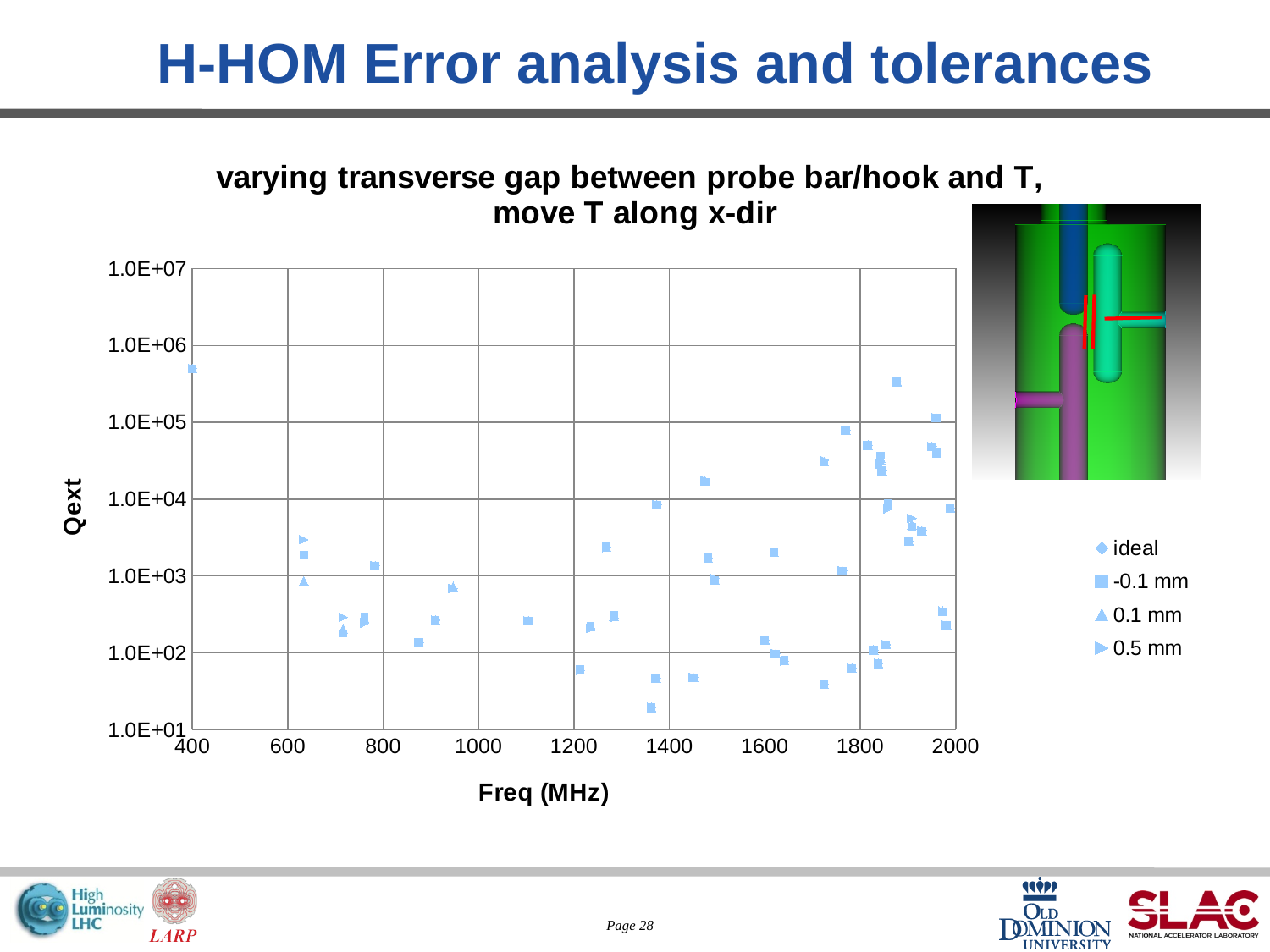
Is the Qext value of the leftmost point (near 400 MHz) greater or less than 1.0E+05? greater What are the series names listed in the legend? ideal, -0.1 mm, 0.1 mm, 0.5 mm Is the Qext value of the point near 1100 MHz greater or less than 1.0E+03? less Is the Qext value of the lowest point on the chart (near 1360 MHz) greater or less than 1.0E+02? less How many series does the legend list? 4 What is the title of the chart? varying transverse gap between probe bar/hook and T, move T along x-dir What kind of chart is shown on the slide? scatter chart